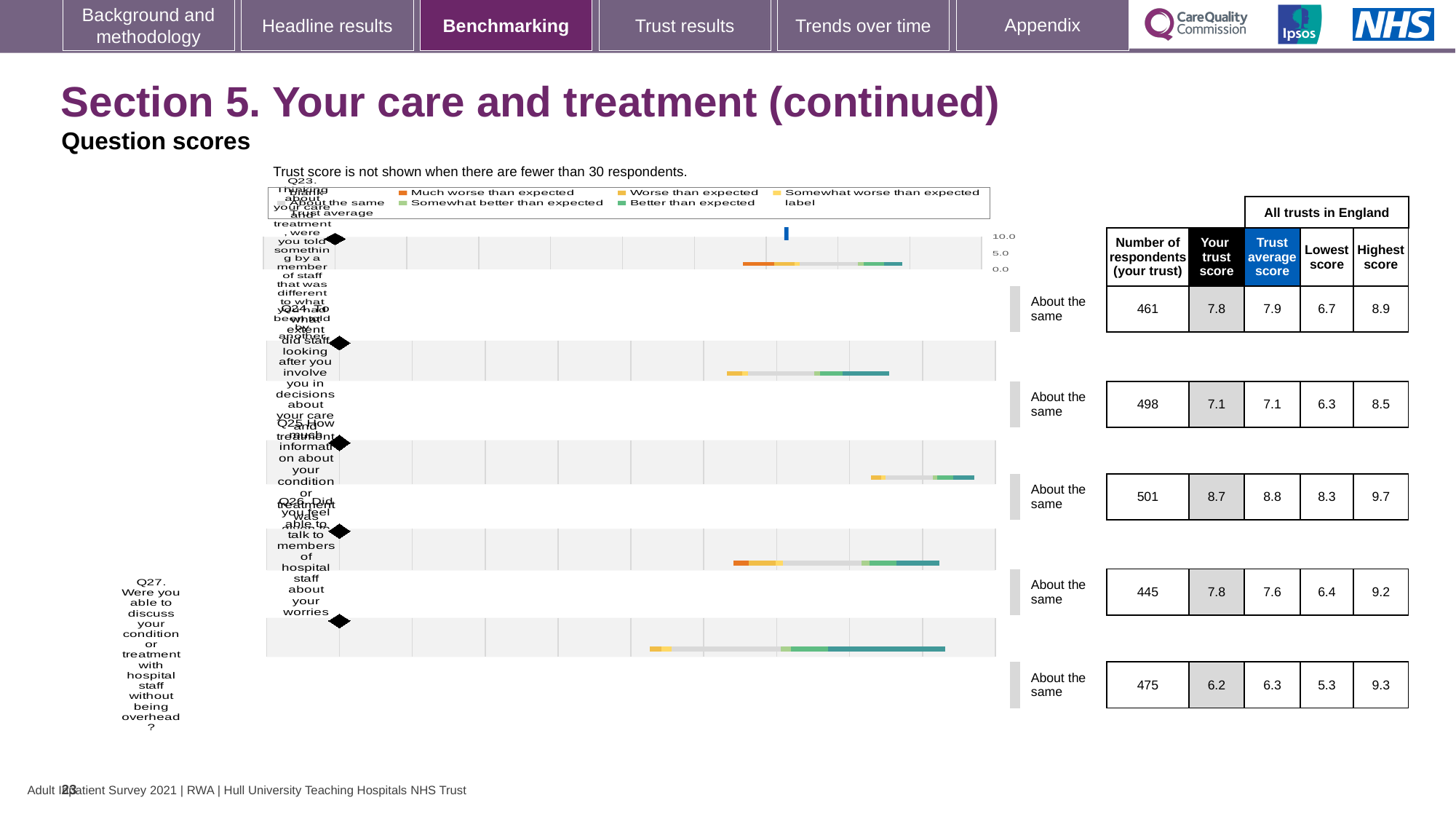
Which question has the highest 'Your trust score'? Q25 What is the 'Highest score' across all trusts in England for Q27? 9.3 What comparison label is shown next to the chart for Q23? About the same How many respondents are shown for Q27? 475 For Q23, which is larger: the 'Your trust score' or the 'Trust average score'? Trust average score How many questions (Q23 to Q27) are plotted on the chart? 5 What is the difference between the 'Your trust score' and the 'Trust average score' for Q26? 0.2 What is the difference between the 'Highest score' and the 'Lowest score' for Q25? 1.4 What is the 'Lowest score' across all trusts in England for Q24? 6.3 Which question has the lowest 'Your trust score'? Q27 What kind of chart is used to show the question scores on this slide? bar chart What is the 'Your trust score' for Q25? 8.7